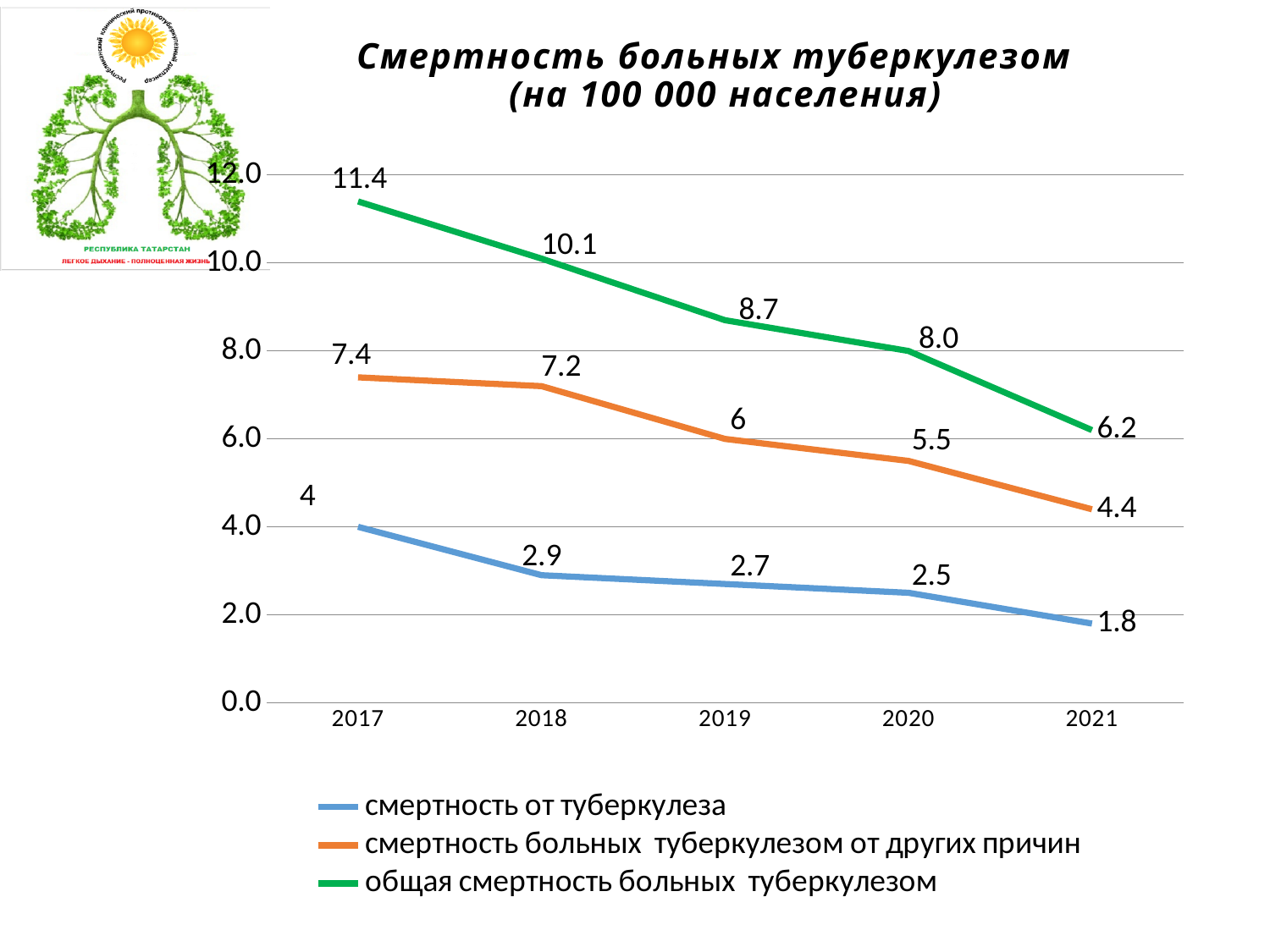
In which year is 'смертность от туберкулеза' lowest? 2021 How many series does the legend list? 3 What is the value of 'смертность больных туберкулезом от других причин' in 2021? 4.4 What is the difference between 'общая смертность больных туберкулезом' in 2017 and in 2021? 5.2 Which is larger in 2020: 'смертность больных туберкулезом от других причин' or 'смертность от туберкулеза'? смертность больных туберкулезом от других причин Do the values of 'смертность больных туберкулезом от других причин' rise or fall from 2017 to 2021? fall What colour is the line for 'общая смертность больных туберкулезом'? green What is the value of 'общая смертность больных туберкулезом' in 2019? 8.7 What is the value of 'смертность от туберкулеза' in 2017? 4 How many years are shown on the x axis? 5 What kind of chart is shown on the slide? line chart In which year is 'общая смертность больных туберкулезом' highest? 2017